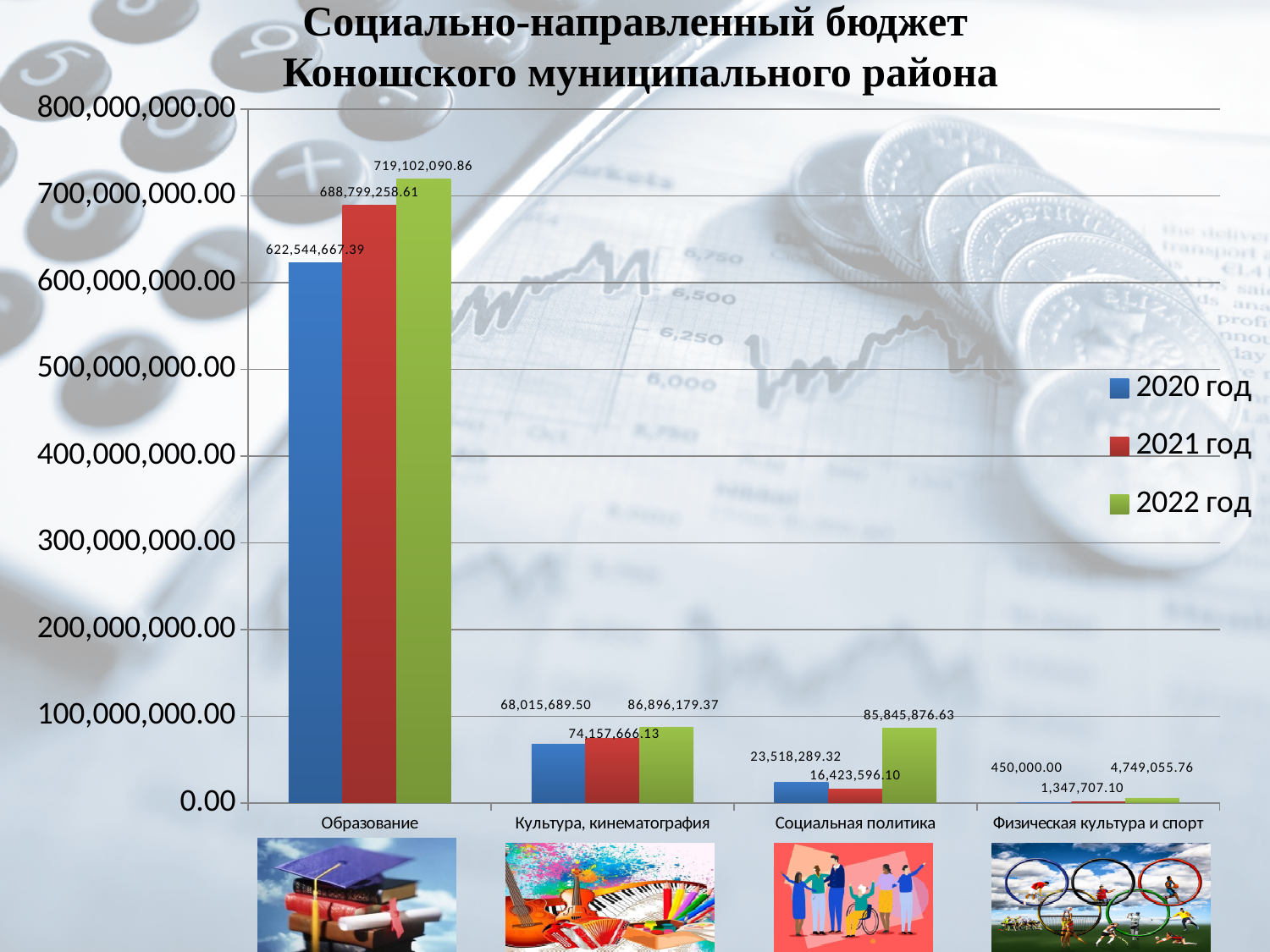
What is the value for Культура, кинематография in 2021 год? 74,157,666.13 Which category has the lowest value in 2020 год? Физическая культура и спорт What is the value for Социальная политика in 2021 год? 16,423,596.10 Which is larger for Социальная политика: the 2020 год value or the 2021 год value? 2020 год How many series does the legend list? 3 What type of chart is shown on the slide? bar chart Which category has the highest value in 2022 год? Образование What is the difference between the 2022 год and 2020 год values for Культура, кинематография? 18,880,489.87 How many categories are shown on the x axis? 4 What is the difference between the 2022 год and 2020 год values for Образование? 96,557,423.47 What is the value for Физическая культура и спорт in 2020 год? 450,000.00 What is the value for Образование in 2022 год? 719,102,090.86